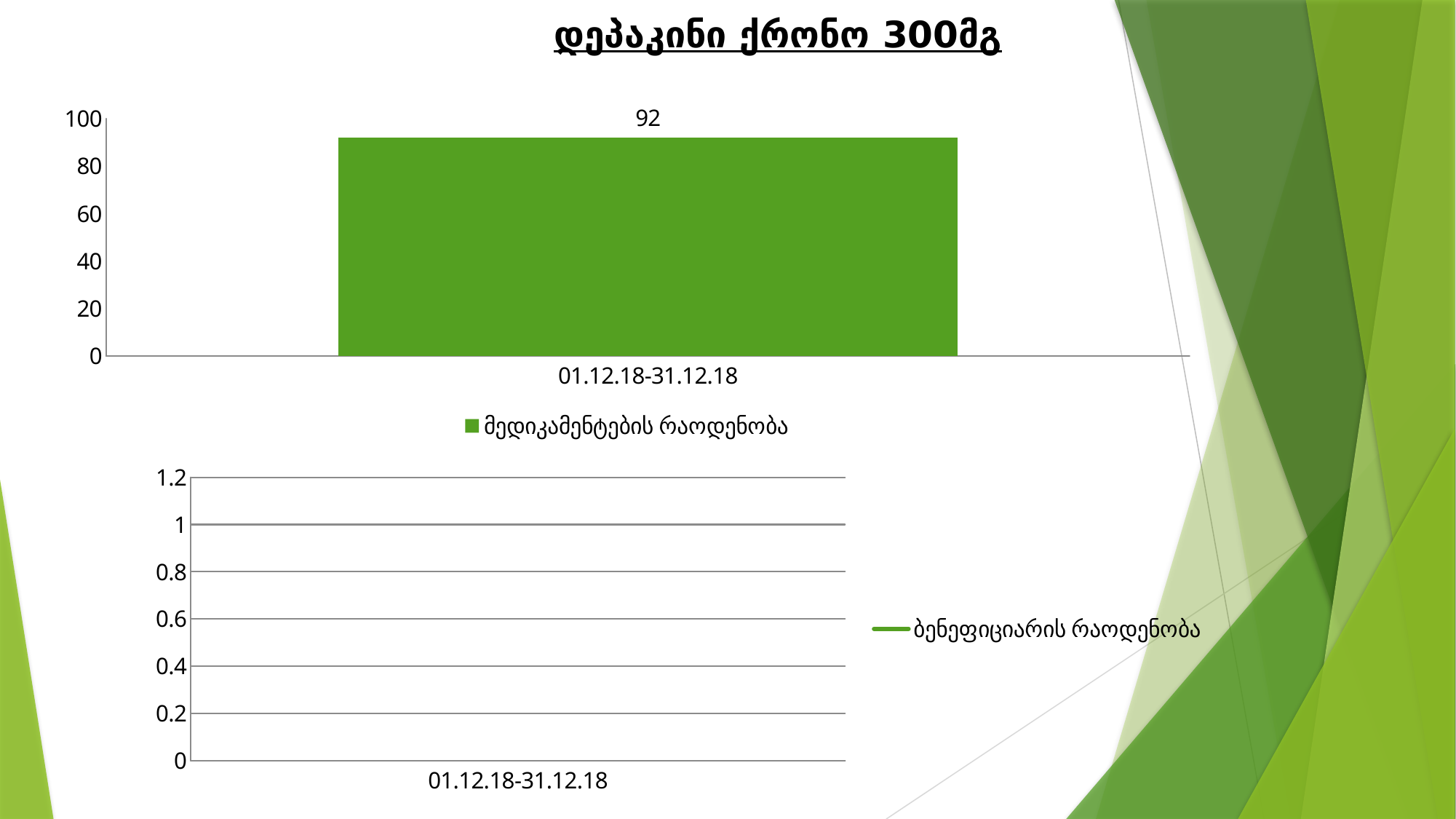
In the top chart, is the value for 01.12.18-31.12.18 greater or less than 100? less How many series does the legend of the bottom chart list? 1 What is the category label on the x axis of the top chart? 01.12.18-31.12.18 How many series does the legend of the top chart list? 1 How many categories are shown on the x axis of the bottom chart? 1 In the top chart, what is the value for 01.12.18-31.12.18? 92 In the top chart, is the value for 01.12.18-31.12.18 greater or less than 80? greater What kind of chart is the top chart on the slide? bar chart What is the legend entry of the top chart? მედიკამენტების რაოდენობა How many bars are plotted in the top chart? 1